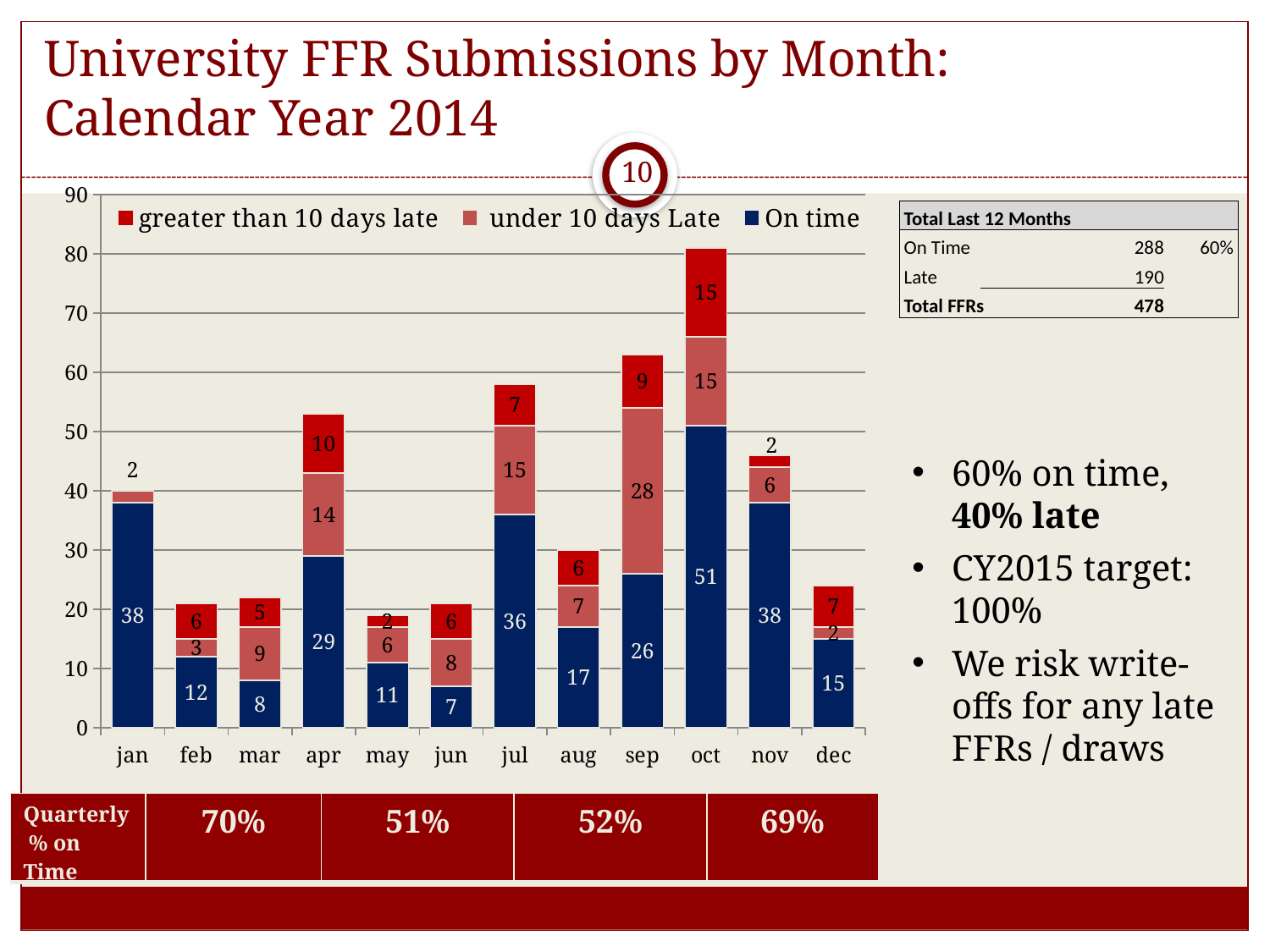
What is the total height of the stacked bar for feb? 21 What kind of chart is shown on the slide? Stacked bar chart Which month has the lowest On time value? jun What is the 'under 10 days Late' value for sep? 28 How many series does the legend list? 3 What is the 'greater than 10 days late' value for apr? 10 What is the On time value for oct? 51 Which is larger, the On time value for apr or for sep? apr What is the difference between the On time values for jul and aug? 19 Which month has the highest On time value? oct What is the total height of the stacked bar for oct? 81 How many months are shown on the x axis? 12